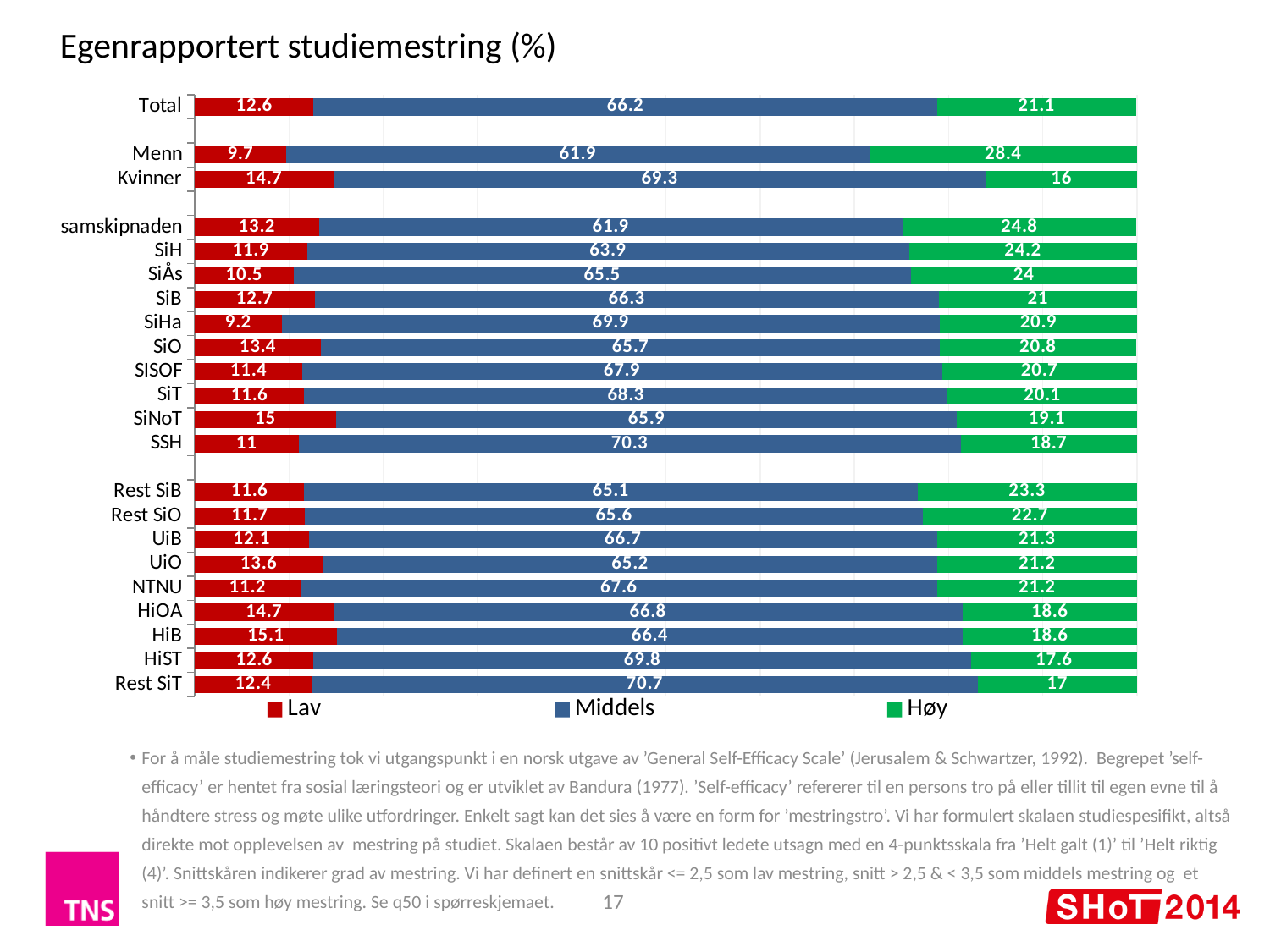
Which has the larger Høy value, samskipnaden or SiB? samskipnaden What is the Lav value for Total? 12.6 What is the difference between the Høy values for Menn and Kvinner? 12.4 Which category has the highest Høy value? Menn What is the total of the stacked bar for Menn? 100 Which category has the lowest Lav value? SiHa What is the Høy value for Menn? 28.4 What kind of chart is shown on the slide? Stacked bar chart How many categories are shown on the chart? 22 What is the Høy value for Rest SiT? 17 How many series does the legend list? 3 What is the Middels value for SSH? 70.3